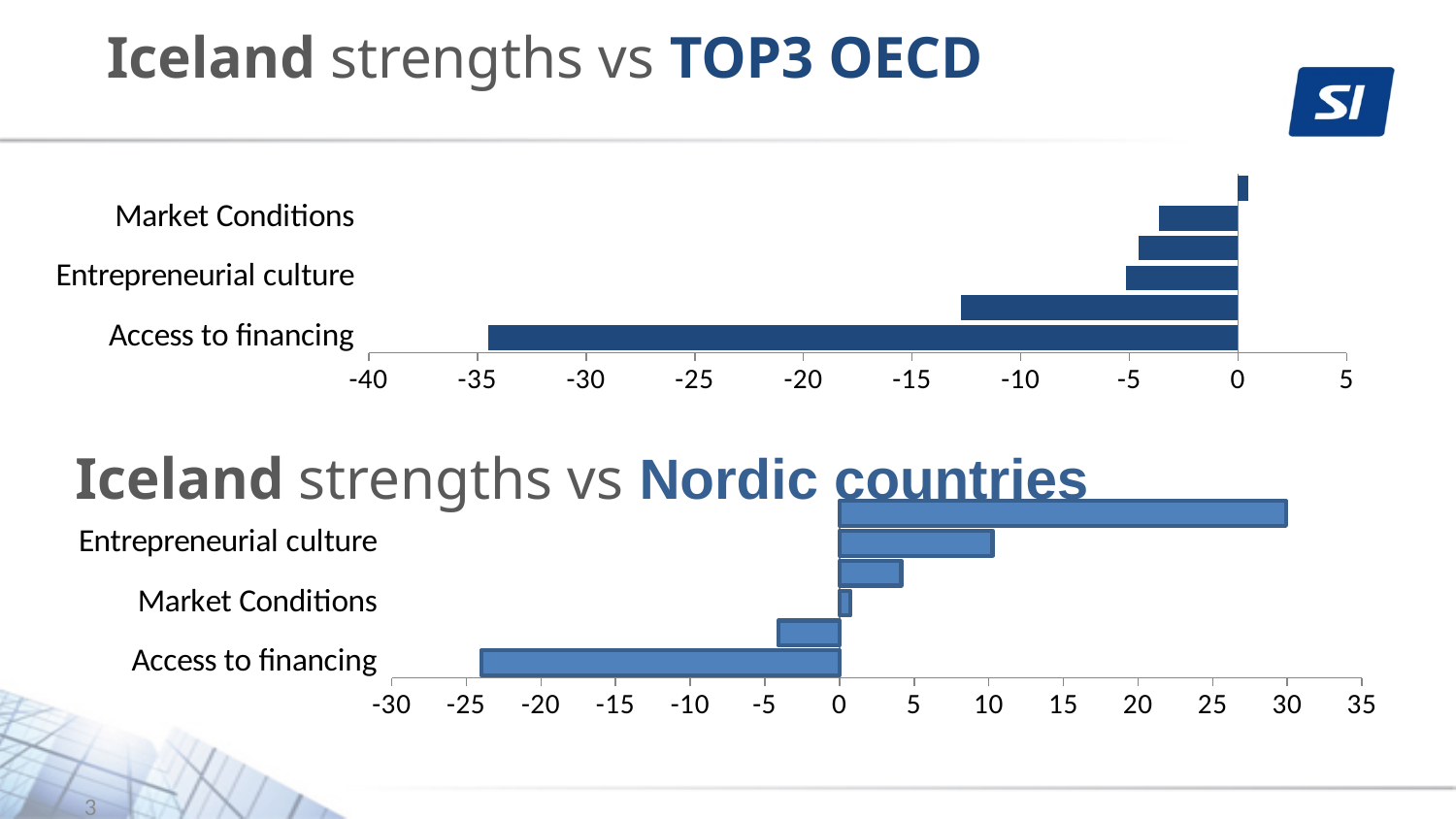
In the 'Iceland strengths vs Nordic countries' chart, which labelled category has the lowest value? Access to financing In the 'Iceland strengths vs TOP3 OECD' chart, which is larger, the value for Market Conditions or the value for Access to financing? Market Conditions In the 'Iceland strengths vs TOP3 OECD' chart, is the value for Access to financing greater or less than -30? less What kind of chart is the 'Iceland strengths vs TOP3 OECD' chart? bar chart In the 'Iceland strengths vs Nordic countries' chart, is the value for Access to financing greater or less than -20? less What is the lowest value shown on the x axis of the 'Iceland strengths vs TOP3 OECD' chart? -40 What kind of chart is the 'Iceland strengths vs Nordic countries' chart? bar chart In the 'Iceland strengths vs Nordic countries' chart, is the value for Entrepreneurial culture greater or less than 5? greater How many bars are plotted in the 'Iceland strengths vs TOP3 OECD' chart? 6 In the 'Iceland strengths vs TOP3 OECD' chart, which labelled category has the lowest value? Access to financing In the 'Iceland strengths vs Nordic countries' chart, which is larger, the value for Entrepreneurial culture or the value for Market Conditions? Entrepreneurial culture